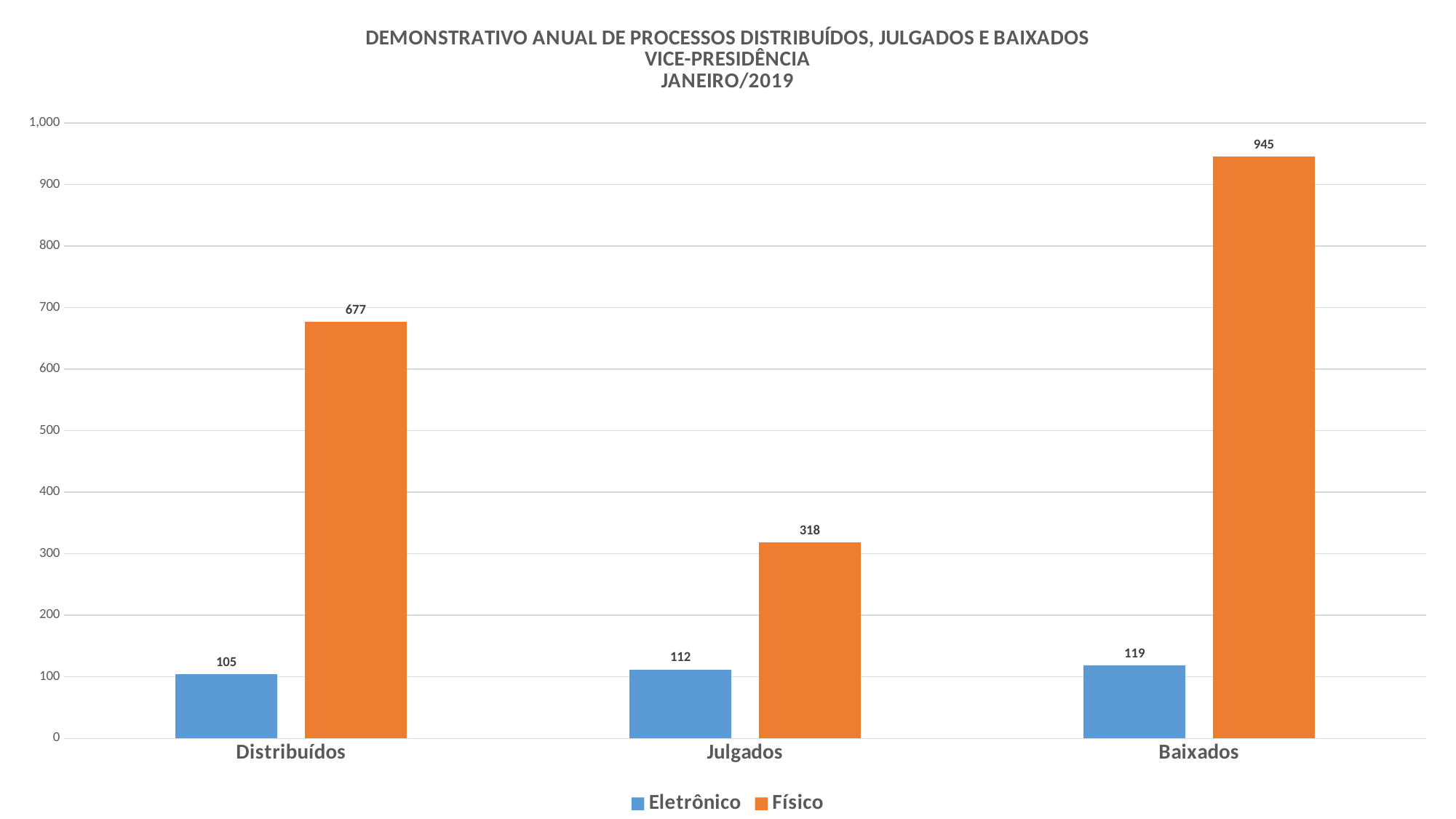
Which is larger for Baixados, Eletrônico or Físico? Físico What is the Eletrônico value for Julgados? 112 What kind of chart is shown on the slide? bar chart How many series does the legend list? 2 What is the Físico value for Baixados? 945 What is the Físico value for Distribuídos? 677 Which category has the highest Físico value? Baixados Is the Físico value for Julgados greater or less than 400? less How many categories are shown on the x axis? 3 Which colour represents the Eletrônico series? blue What is the difference between the Físico and Eletrônico values for Julgados? 206 Which category has the lowest Eletrônico value? Distribuídos